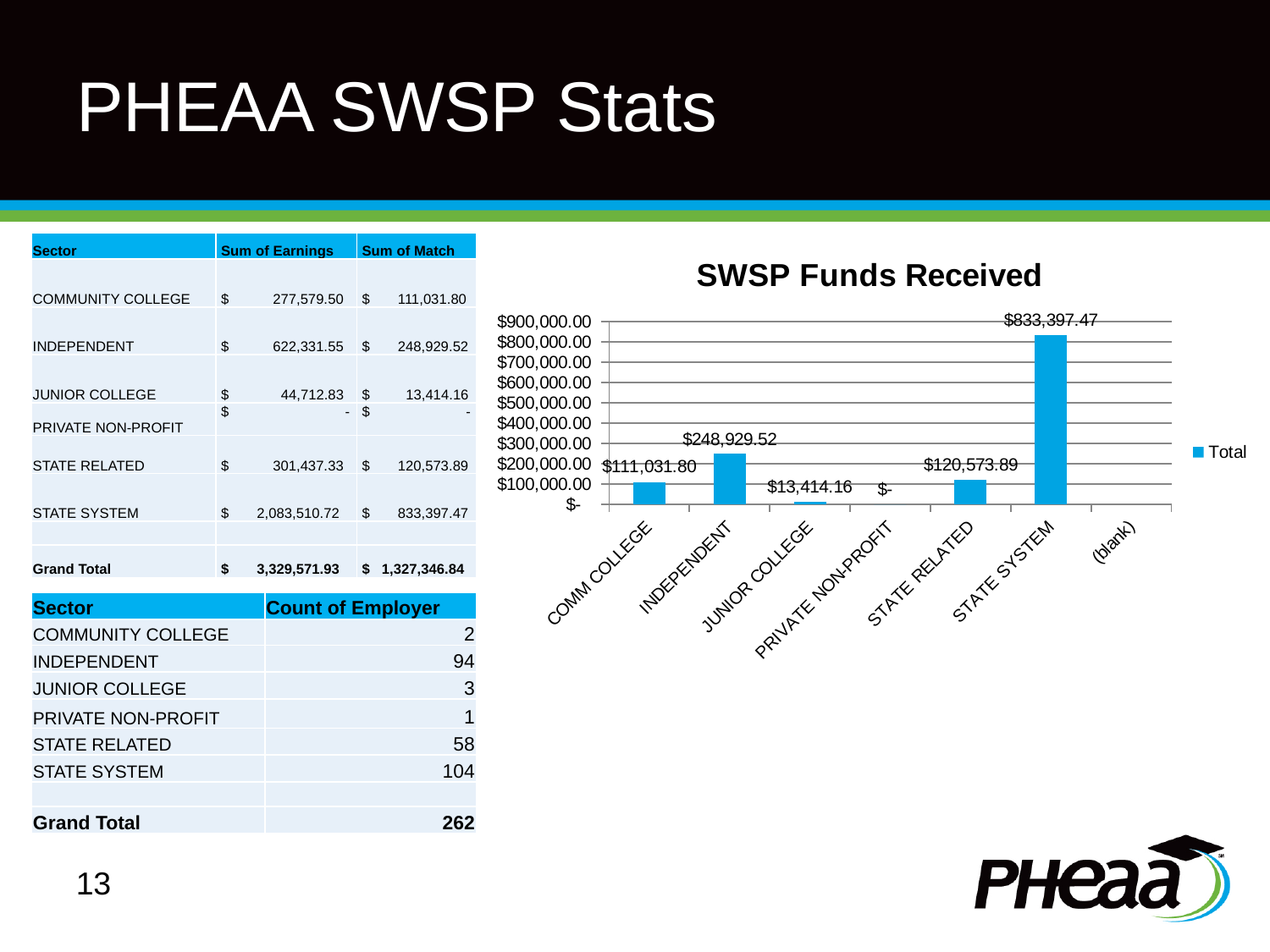
How many series does the legend of the SWSP Funds Received chart list? 1 In the SWSP Funds Received chart, which category with a non-zero value has the lowest value? JUNIOR COLLEGE In the SWSP Funds Received chart, which category has the highest value? STATE SYSTEM In the SWSP Funds Received chart, what is the value for STATE RELATED? $120,573.89 In the SWSP Funds Received chart, is the value for STATE SYSTEM greater or less than $800,000.00? greater In the SWSP Funds Received chart, what is the value for INDEPENDENT? $248,929.52 In the SWSP Funds Received chart, what is the difference between the values for STATE SYSTEM and INDEPENDENT? $584,467.95 In the SWSP Funds Received chart, what is the value for STATE SYSTEM? $833,397.47 In the SWSP Funds Received chart, which is larger, the value for INDEPENDENT or the value for STATE RELATED? INDEPENDENT In the SWSP Funds Received chart, what is the difference between the values for STATE RELATED and COMM COLLEGE? $9,542.09 In the SWSP Funds Received chart, what is the value for JUNIOR COLLEGE? $13,414.16 What kind of chart is the SWSP Funds Received chart? bar chart